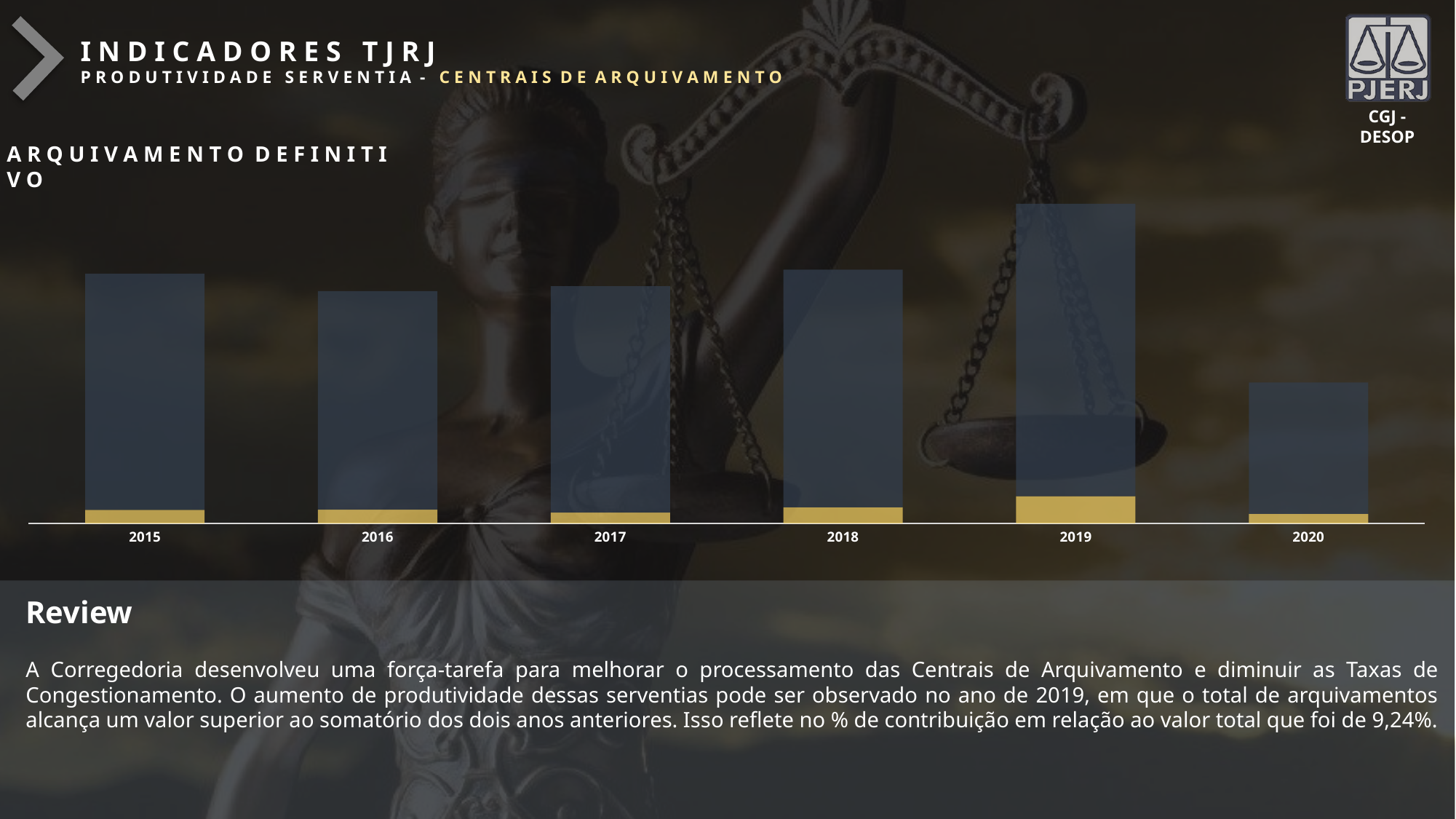
What is the first year shown on the x axis of the chart? 2015 How many years are shown on the x axis of the chart? 6 Do the bars rise or fall from 2019 to 2020? fall Which year has the largest gold segment at the bottom of its bar? 2019 Which year has the tallest bar in the chart? 2019 What is the title shown above the chart? ARQUIVAMENTO DEFINITIVO Which year has the shortest bar in the chart? 2020 Which year has a taller bar, 2015 or 2016? 2015 What kind of chart is shown on the slide? bar chart Do the bars rise or fall from 2018 to 2019? rise Which year has a taller bar, 2018 or 2017? 2018 Which year has a taller bar, 2019 or 2020? 2019